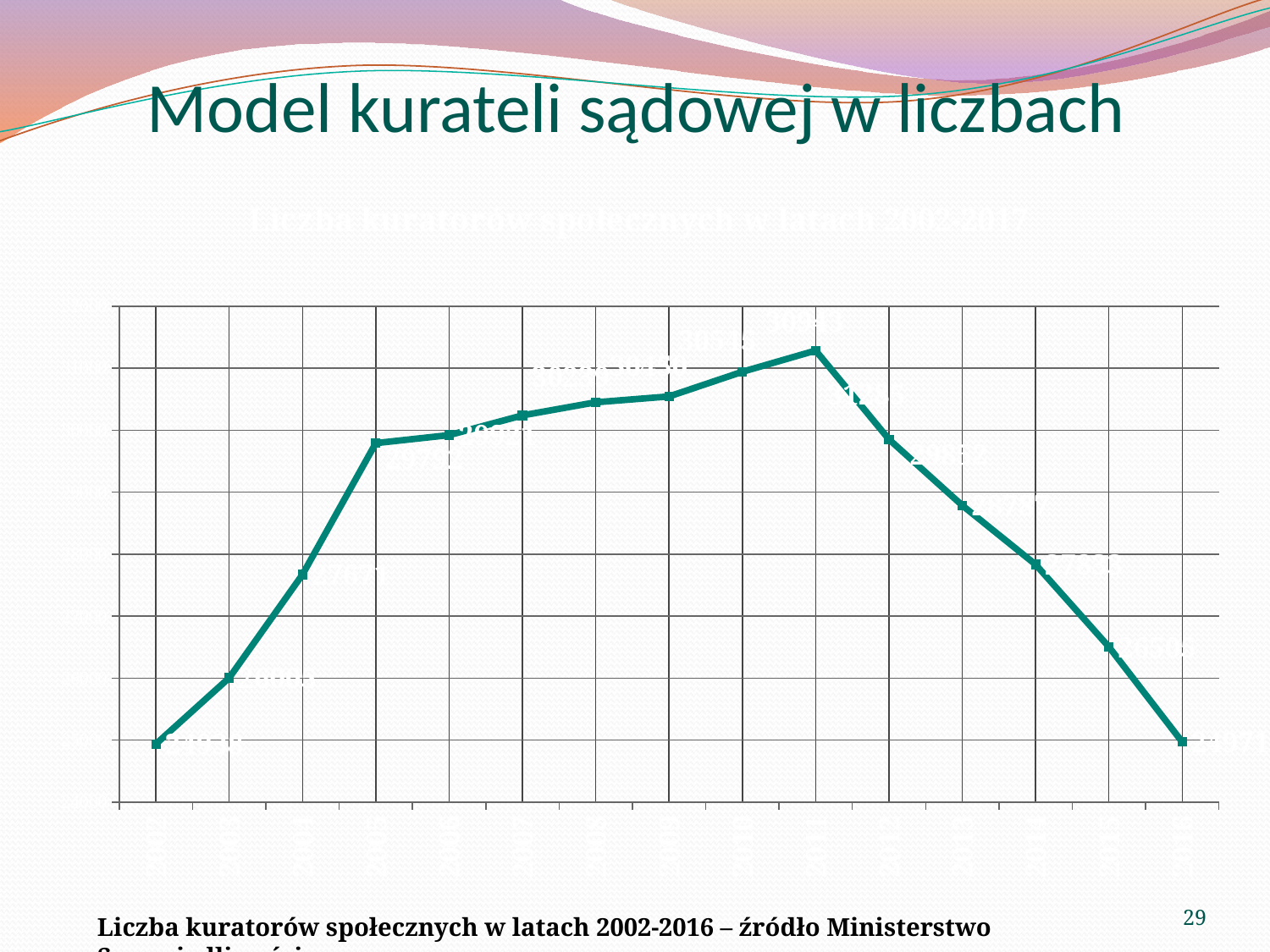
Which is larger, the value for 2011 or the value for 2016? 2011 How many data points are plotted on the line chart? 15 Which year has the highest value on the line chart? 2011 Do the values rise or fall from 2011 to 2016? fall Which is larger, the value for 2005 or the value for 2004? 2005 What colour is the plotted line? teal green Do the values rise or fall from 2002 to 2005? rise What is the value plotted for 2011, the peak of the line? 31285 What kind of chart is shown on the slide? line chart Which is larger, the value for 2003 or the value for 2014? 2014 What is the title of the chart? Liczba kuratorów społecznych w latach 2002-2017